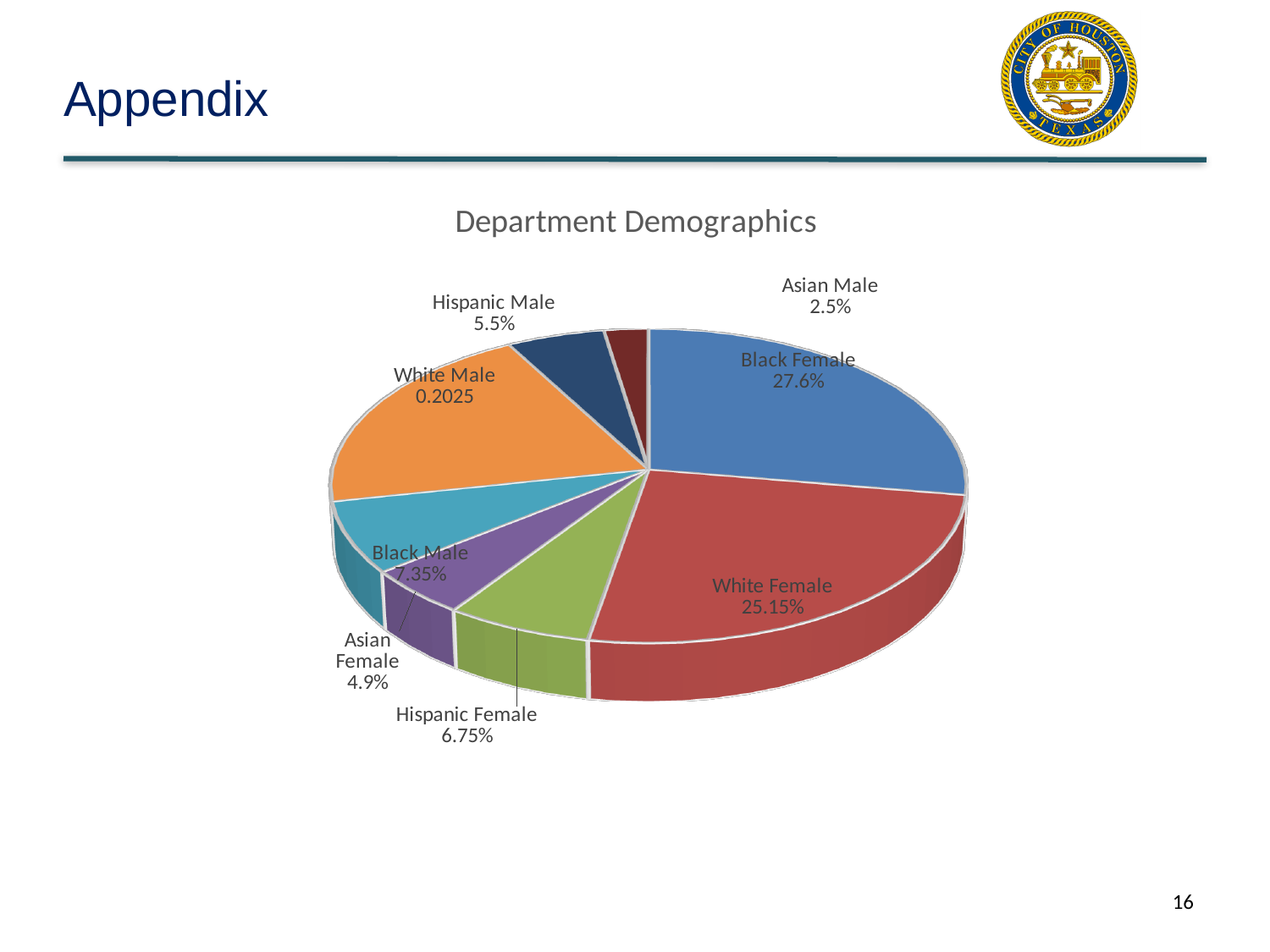
What percentage is shown for Black Female? 27.6% What type of chart is shown on the slide? pie chart What is the difference between the Black Female and White Female percentages? 2.45% Which category has the largest slice of the pie? Black Female What value is shown for White Female? 25.15% What is the difference between the Hispanic Male and Asian Male percentages? 3% How many slices does the pie chart have? 8 Which category has the smallest slice of the pie? Asian Male What value is printed for the White Male slice? 0.2025 What percentage is shown for Hispanic Female? 6.75% What is the title of the chart? Department Demographics Which is larger, the Black Male slice or the Hispanic Female slice? Black Male